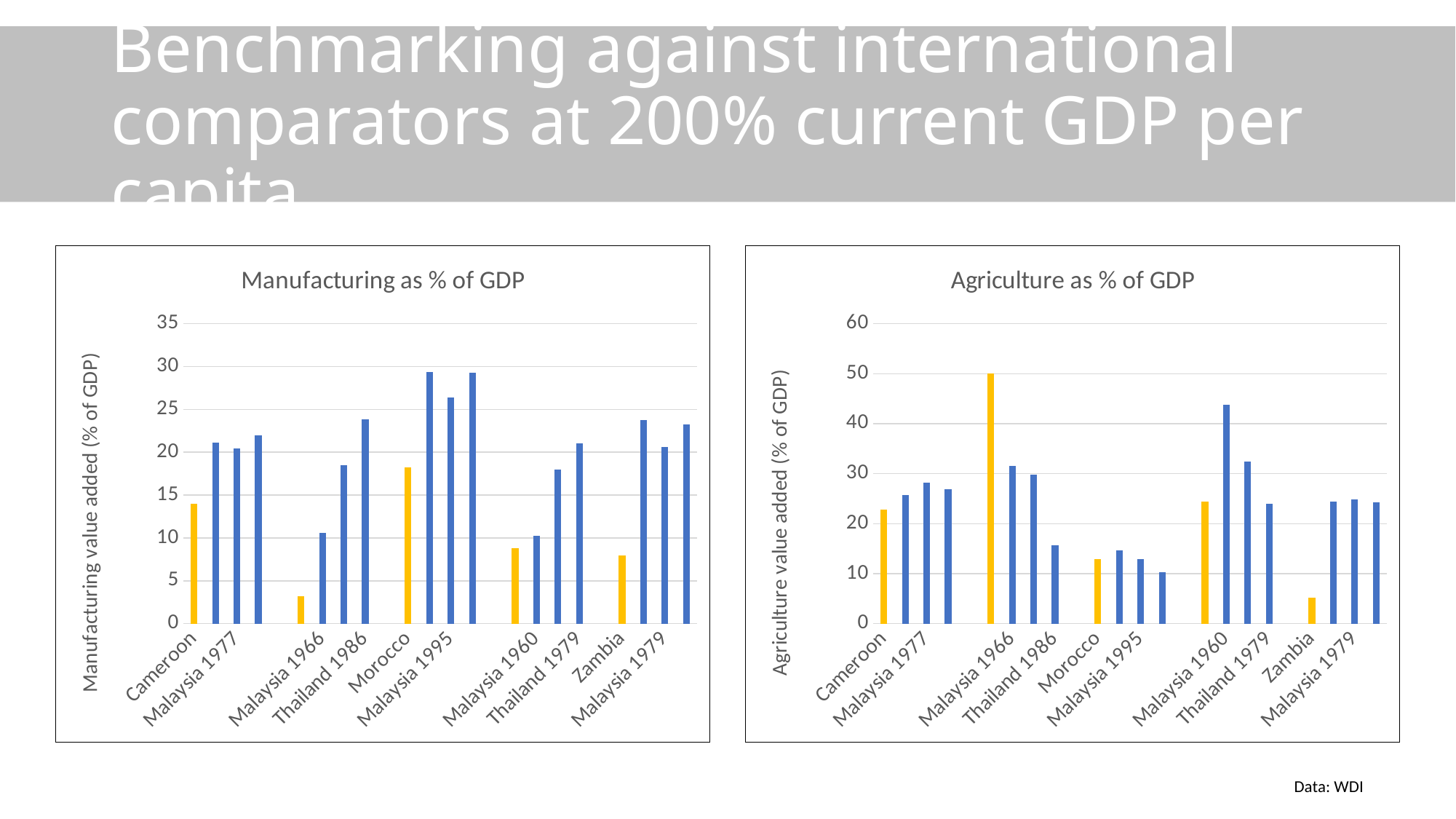
In the Manufacturing as % of GDP chart, is the value for Morocco greater or less than 20? less In the Agriculture as % of GDP chart, is the value for Cameroon greater or less than 20? greater In the Manufacturing as % of GDP chart, is the value for Malaysia 1995 greater or less than 25? greater In the Agriculture as % of GDP chart, which labelled category has the lowest value? Zambia What kind of chart is the Agriculture as % of GDP chart? Bar chart In the Agriculture as % of GDP chart, which is larger, the value for Cameroon or the value for Morocco? Cameroon What is the y-axis title of the Manufacturing as % of GDP chart? Manufacturing value added (% of GDP) In the Manufacturing as % of GDP chart, which is larger, the value for Cameroon or the value for Zambia? Cameroon